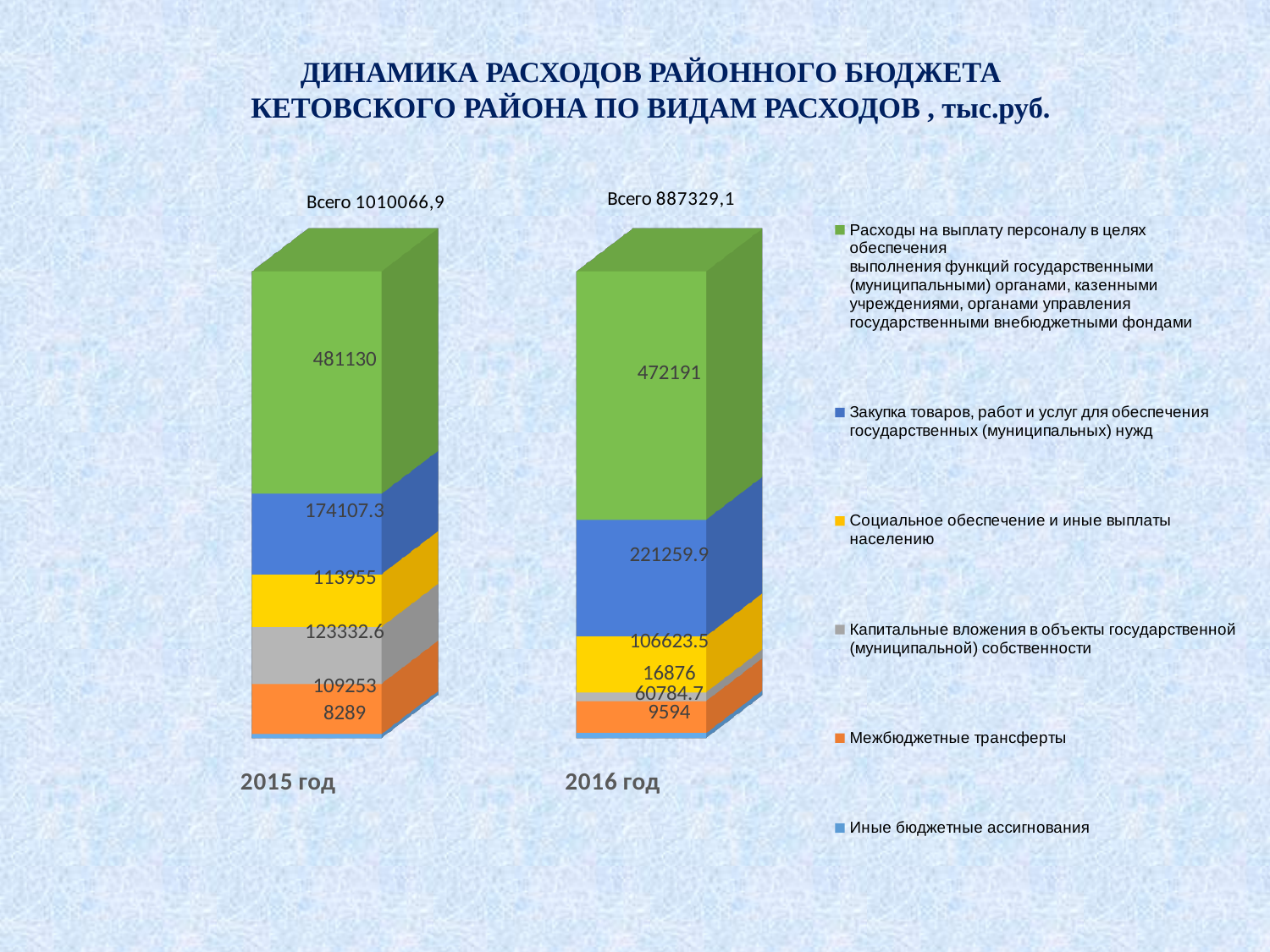
Which series has the largest value in the 2016 год bar? Расходы на выплату персоналу в целях обеспечения выполнения функций государственными (муниципальными) органами, казенными учреждениями, органами управления государственными внебюджетными фондами How many categories (years) are plotted on the x axis? 2 How many series does the legend list? 6 What kind of chart is shown on the slide? bar chart What is the difference between the green segment values for 2015 год (481130) and 2016 год (472191)? 8939 What is the total of the stacked bar for 2016 год, as printed on the slide? Всего 887329,1 What is the value of the green segment (Расходы на выплату персоналу...) for 2015 год? 481130 What is the value of the gray segment (Капитальные вложения...) for 2016 год? 16876 What is the value of the blue segment (Закупка товаров, работ и услуг...) for 2016 год? 221259.9 What is the value of the light blue segment (Иные бюджетные ассигнования) for 2015 год? 8289 What is the total of the stacked bar for 2015 год, as printed on the slide? Всего 1010066,9 Which year has the larger value for the orange segment (Межбюджетные трансферты): 2015 год or 2016 год? 2015 год